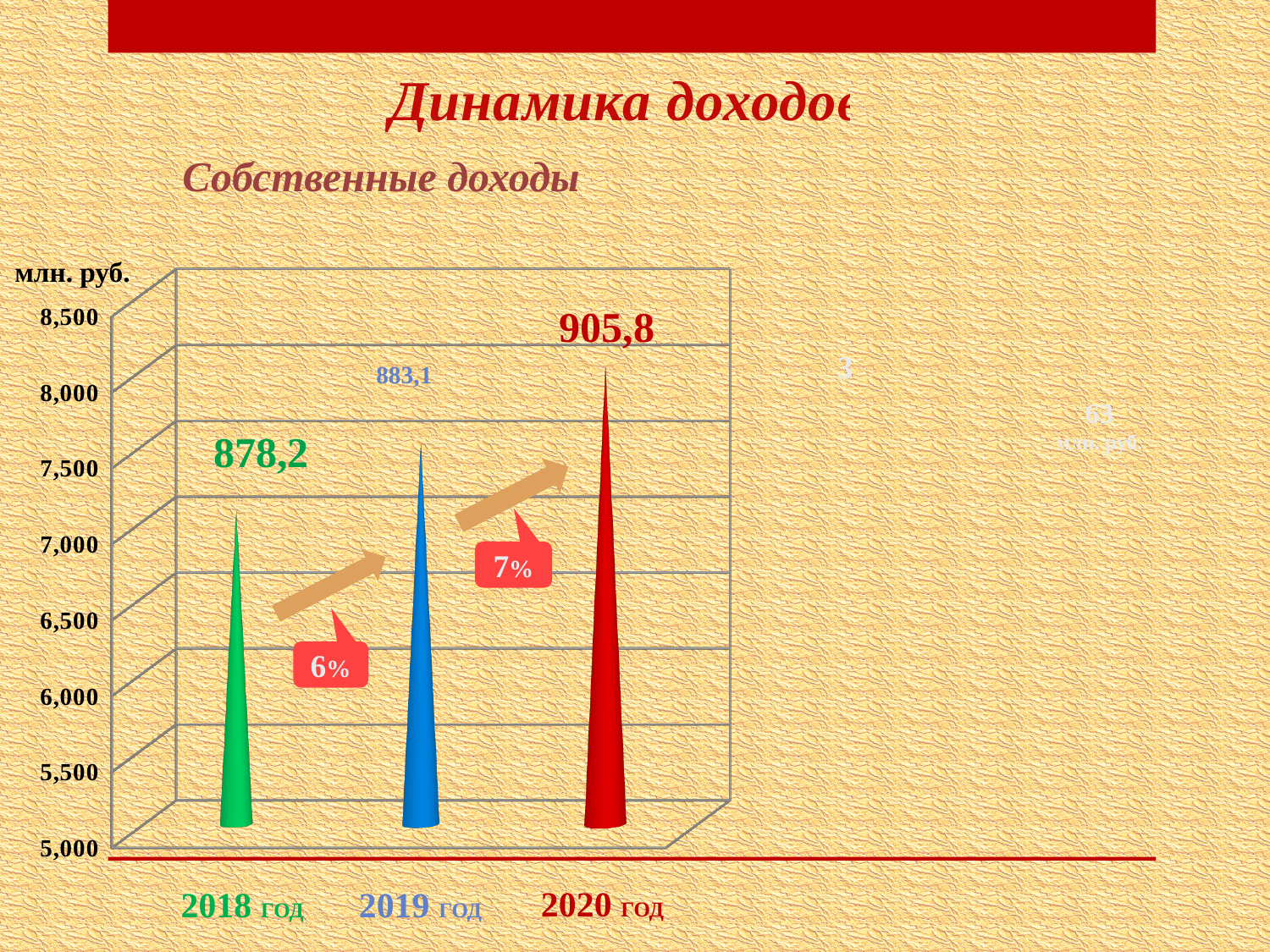
What percentage growth is shown between 2019 год and 2020 год? 7% What kind of chart is shown on the slide? bar chart How many years are shown on the chart? 3 Which year has the lowest value? 2018 год Which is larger, the value for 2019 год or the value for 2018 год? 2019 год Which year has the highest value? 2020 год Do the values rise or fall from 2018 год to 2020 год? rise